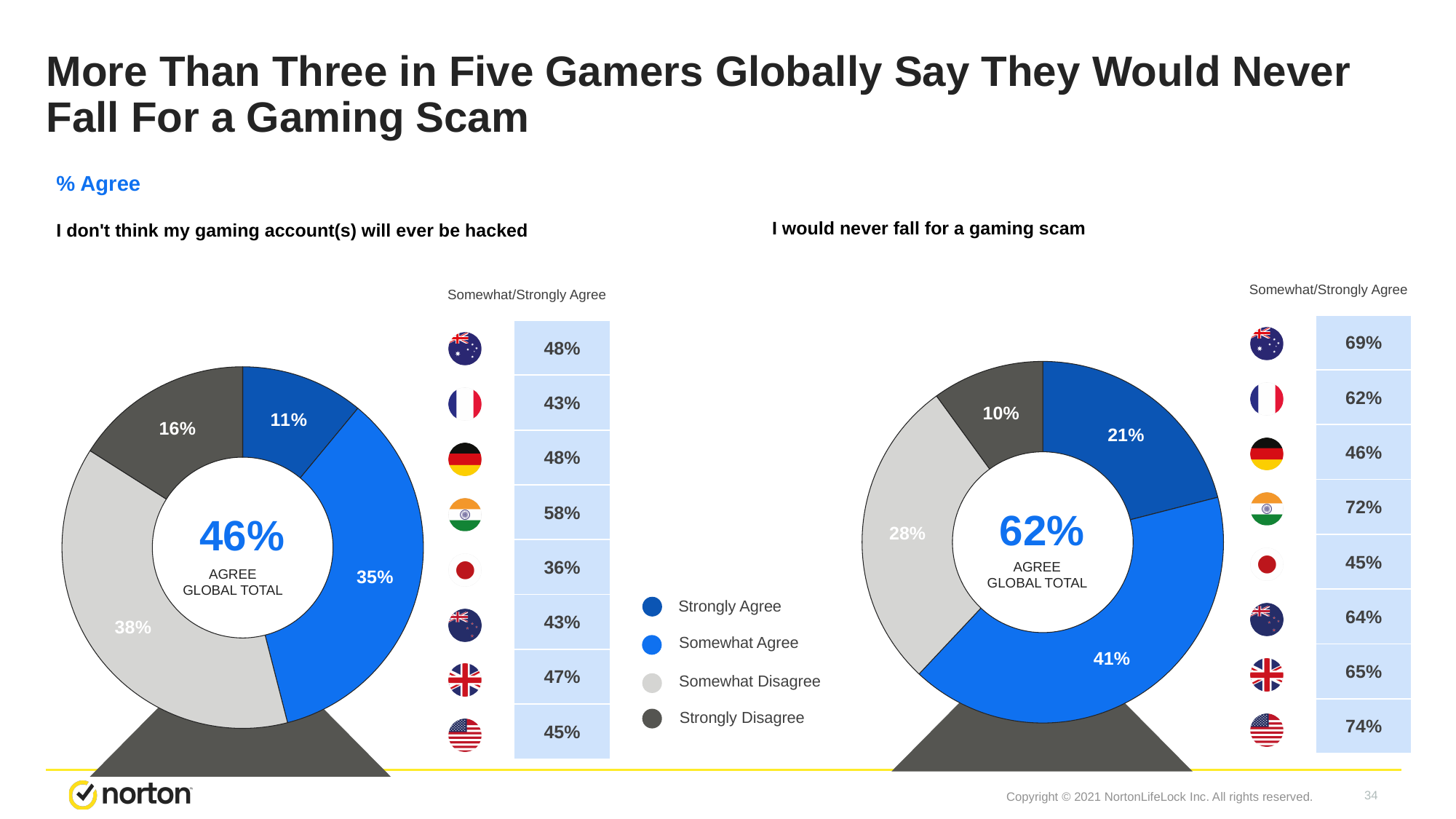
What kind of chart is used for 'I don't think my gaming account(s) will ever be hacked'? Donut (pie) chart In the 'I don't think my gaming account(s) will ever be hacked' chart, what percentage is Somewhat Agree? 35% In the 'I don't think my gaming account(s) will ever be hacked' chart, which is larger: Somewhat Disagree or Somewhat Agree? Somewhat Disagree In the 'I don't think my gaming account(s) will ever be hacked' chart, which response has the smallest share? Strongly Agree How many response categories does the legend list? 4 In the 'I would never fall for a gaming scam' chart, what percentage is Strongly Agree? 21% In the 'I don't think my gaming account(s) will ever be hacked' chart, what percentage is Strongly Disagree? 16% Which colour represents Strongly Disagree in the legend? Dark grey In the 'I would never fall for a gaming scam' chart, which response has the largest share? Somewhat Agree In the 'I would never fall for a gaming scam' chart, what is the difference between Somewhat Agree and Strongly Agree? 20% What is the Agree Global Total shown in the centre of the 'I would never fall for a gaming scam' chart? 62% In the 'I would never fall for a gaming scam' chart, what percentage is Somewhat Disagree? 28%